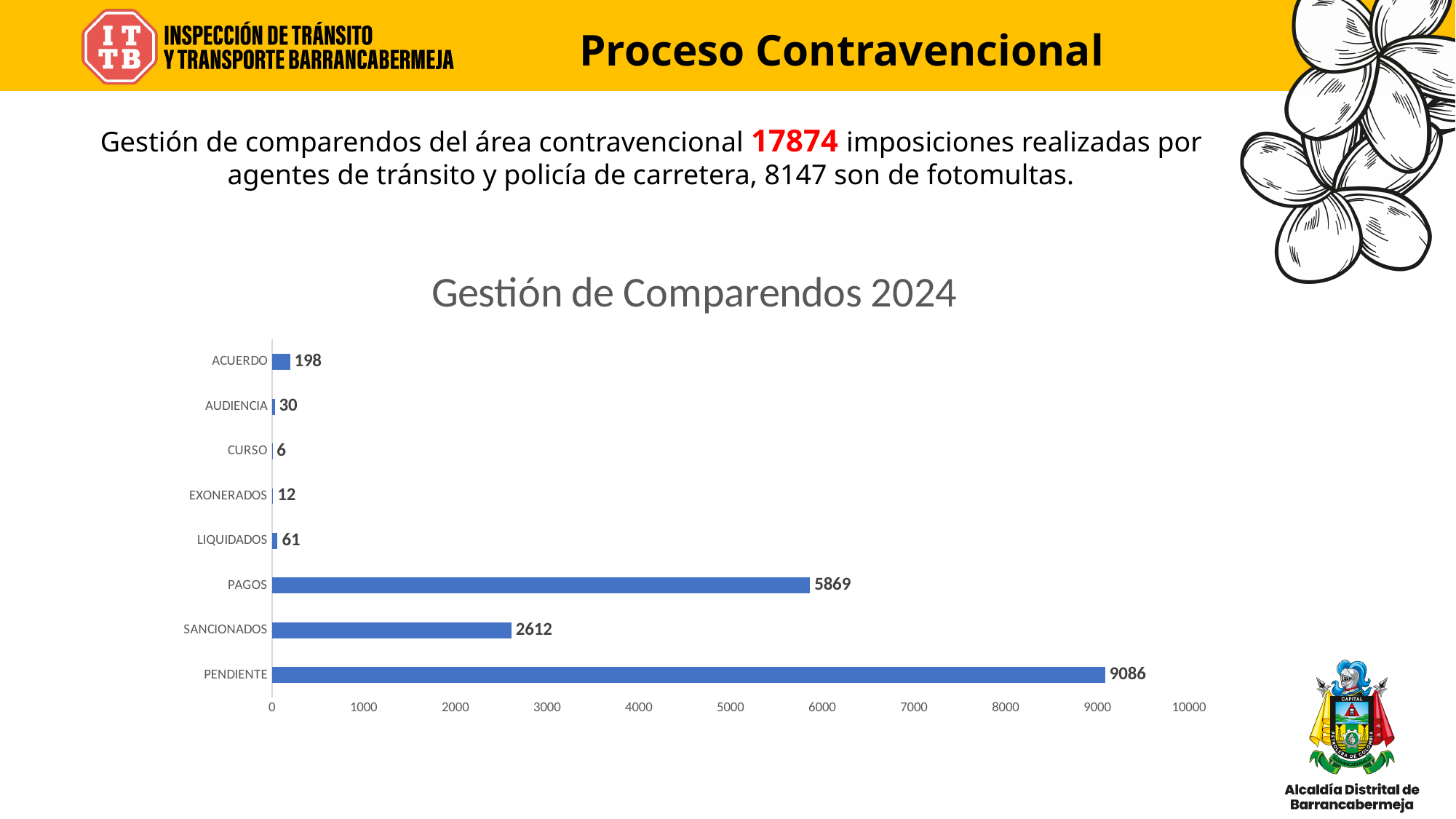
Which category has the lowest value? CURSO Which is larger, the value for AUDIENCIA or the value for LIQUIDADOS? LIQUIDADOS What is the title of the chart? Gestión de Comparendos 2024 Which category has the highest value? PENDIENTE What is the difference between the values for PENDIENTE and PAGOS? 3217 What kind of chart is shown? Bar chart What is the value for PENDIENTE? 9086 How many categories are shown in the chart? 8 What is the value for SANCIONADOS? 2612 What is the value for PAGOS? 5869 What is the value for ACUERDO? 198 What is the value for CURSO? 6